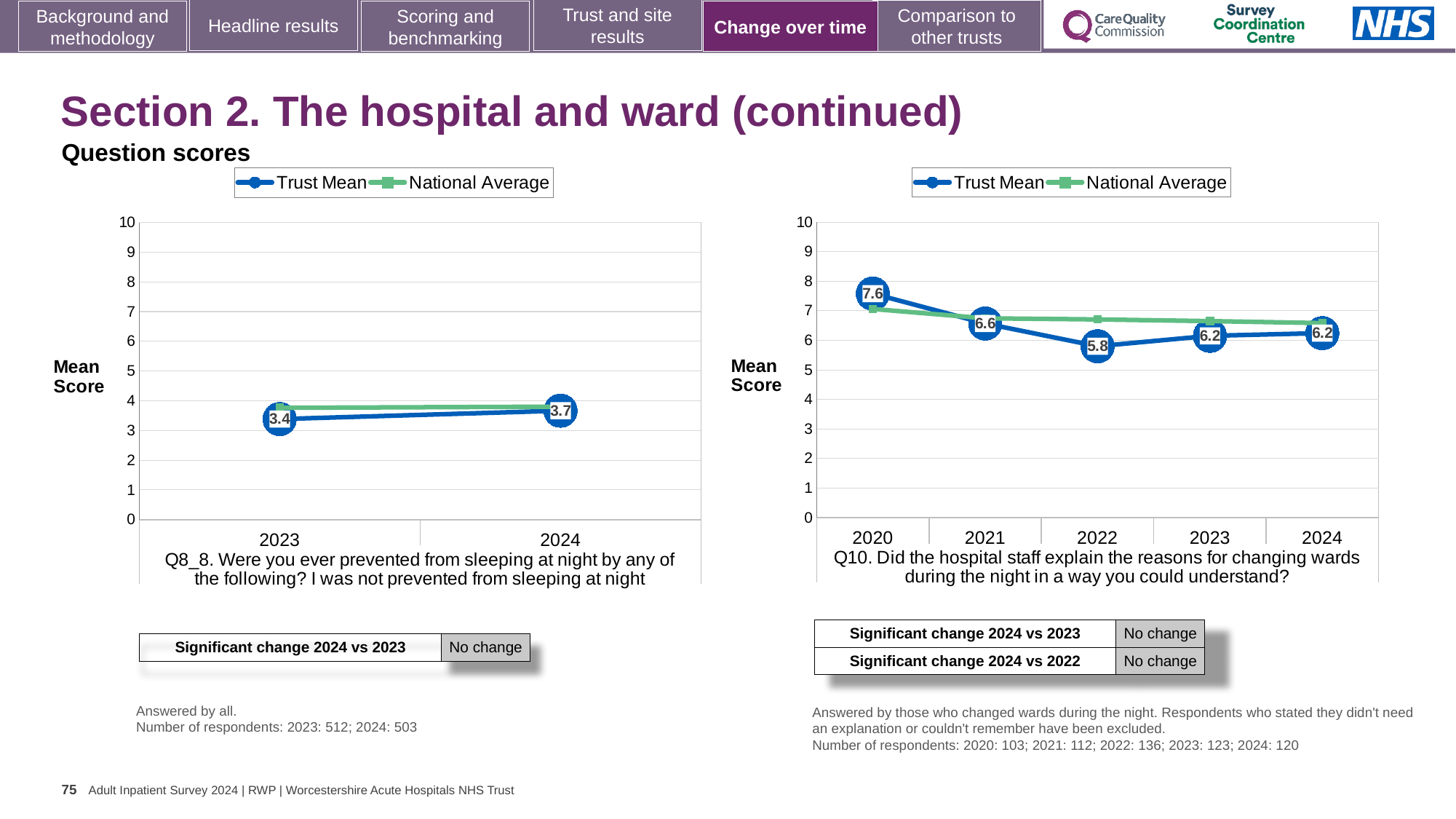
In the right chart (Q10), which year has the highest Trust Mean score? 2020 In the right chart (Q10), which year has the lowest Trust Mean score? 2022 In the left chart (Q8_8), what is the Trust Mean score for 2023? 3.4 In the left chart (Q8_8), what is the difference between the Trust Mean scores for 2024 and 2023? 0.3 In the right chart (Q10), what is the Trust Mean score for 2022? 5.8 In the left chart (Q8_8), what is the Trust Mean score for 2024? 3.7 In the right chart (Q10), what is the difference between the Trust Mean scores for 2020 and 2021? 1.0 In the right chart (Q10), what is the Trust Mean score for 2020? 7.6 In the left chart (Q8_8), how many series does the legend list? 2 In the right chart (Q10), how many years are shown on the x axis? 5 In the right chart (Q10), is the Trust Mean score for 2021 greater or less than 6? greater What type of chart is used on the right side of the slide (Q10)? Line chart